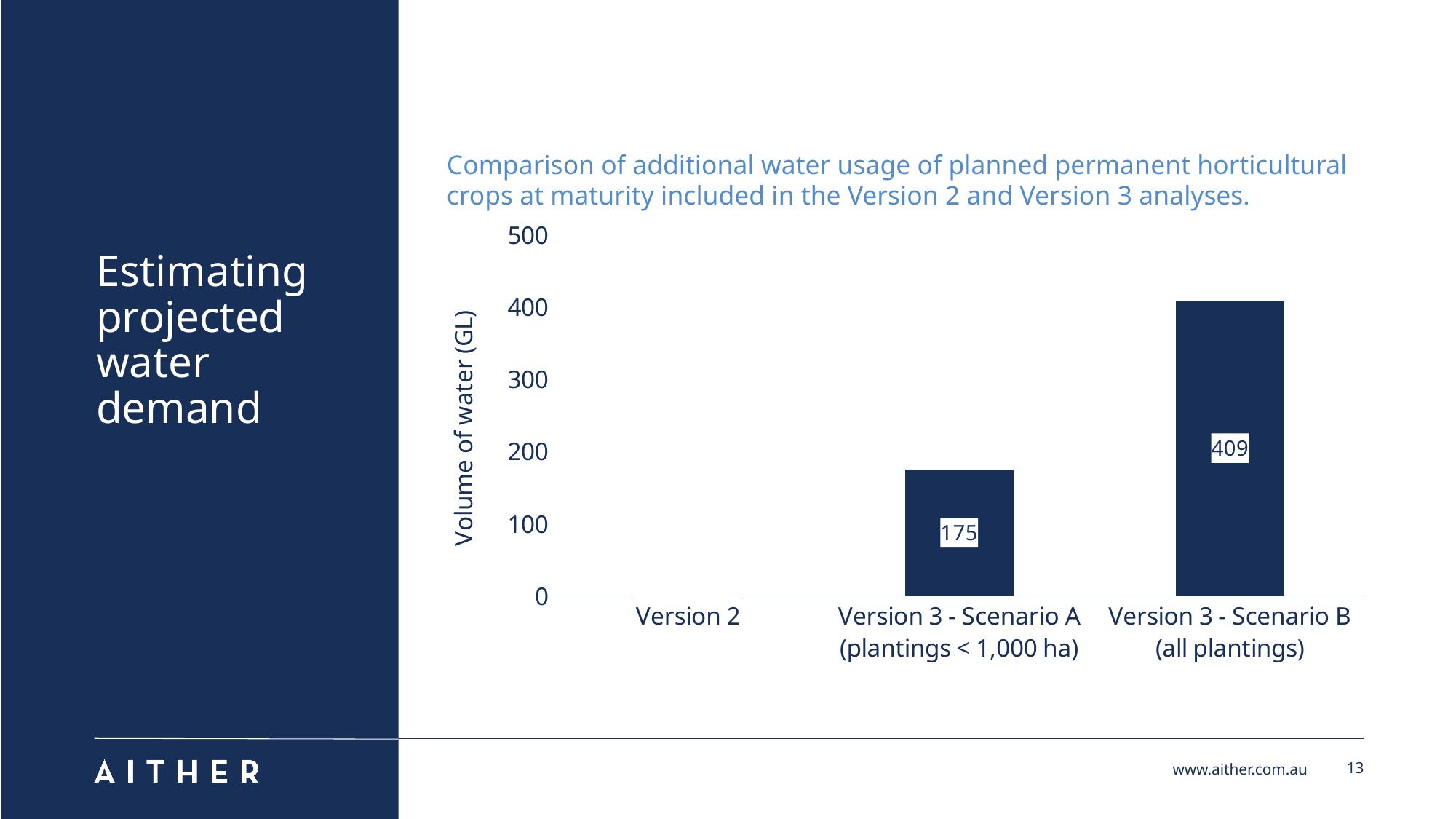
What is the difference between the values for Version 3 - Scenario B and Version 3 - Scenario A? 234 Which is larger, the value for Version 3 - Scenario A or Version 3 - Scenario B? Version 3 - Scenario B What is the label of the vertical axis? Volume of water (GL) What is the value for Version 3 - Scenario B (all plantings)? 409 Is the value for Version 3 - Scenario A greater or less than 200? less What is the highest value shown on the vertical axis? 500 Do the values rise or fall from left to right across the x axis? rise What kind of chart is shown on the slide? bar chart Which category has the highest volume of water? Version 3 - Scenario B (all plantings) Is the value for Version 3 - Scenario B greater or less than 300? greater What is the value for Version 3 - Scenario A (plantings < 1,000 ha)? 175 How many categories are shown on the x axis? 3